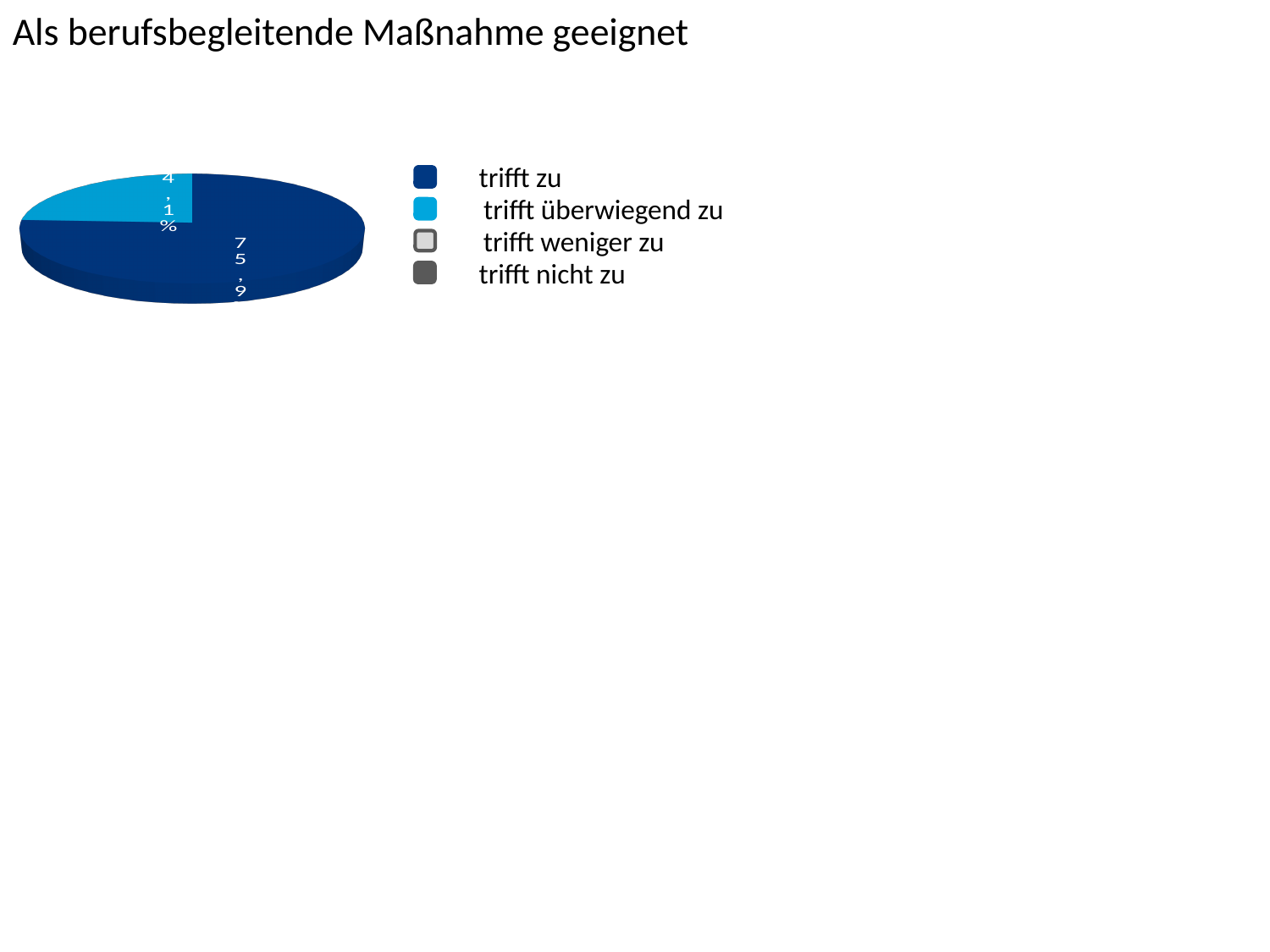
Which legend entry is shown in light blue? trifft überwiegend zu How many entries does the legend of the pie chart list? 4 What kind of chart is shown on the slide? pie chart How many slices are visible in the pie chart? 2 Which category has the largest slice in the pie chart? trifft zu Which slice is larger, "trifft zu" or "trifft überwiegend zu"? trifft zu What is the title of the slide containing the pie chart? Als berufsbegleitende Maßnahme geeignet Which legend entry is shown in dark blue? trifft zu